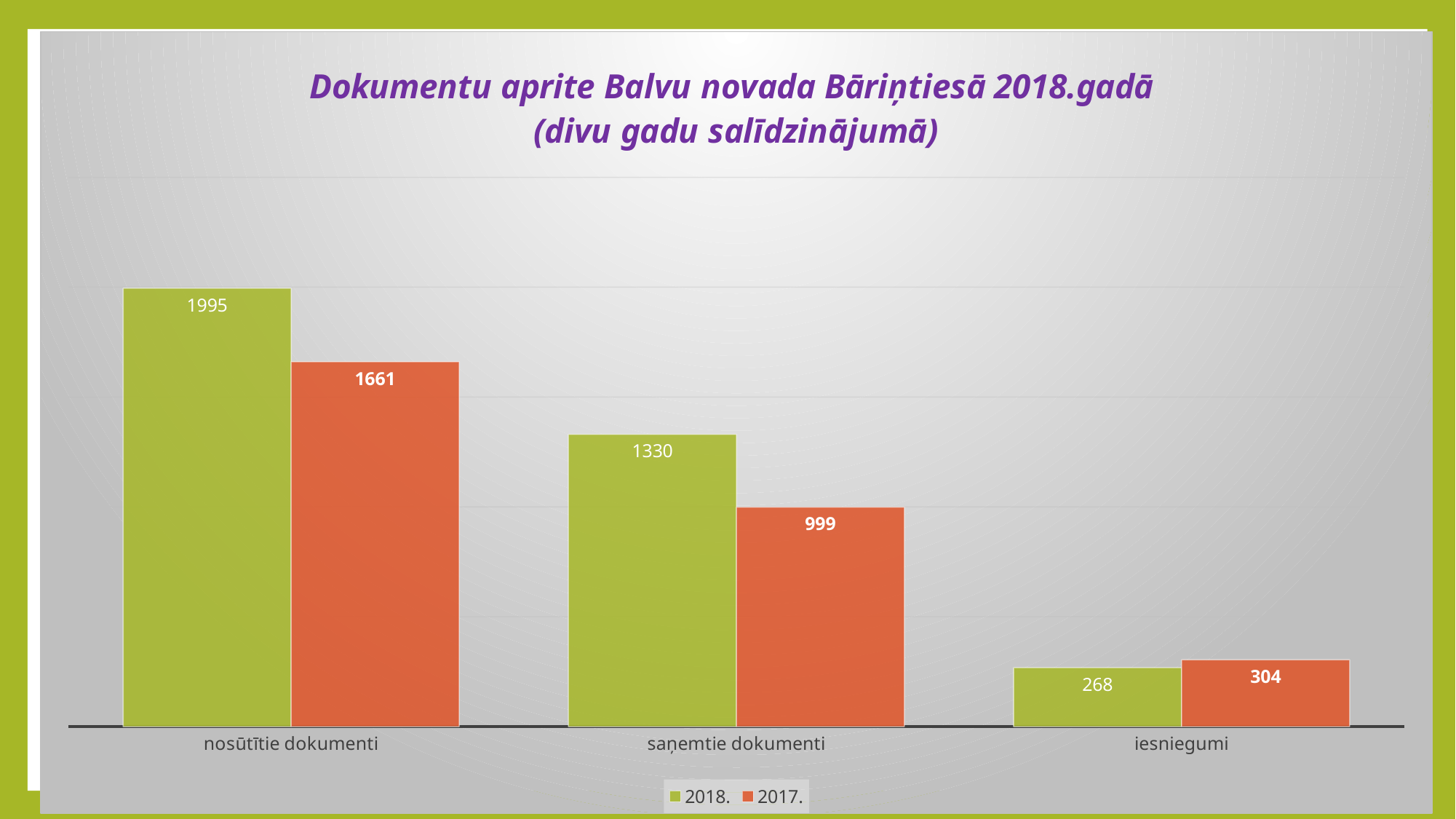
How many categories are shown on the x axis? 3 What is the value for saņemtie dokumenti in 2017.? 999 What is the difference between the 2018. and 2017. values for saņemtie dokumenti? 331 What kind of chart is shown on the slide? bar chart What is the value for iesniegumi in 2018.? 268 How many series does the legend list? 2 What is the difference between the 2018. and 2017. values for nosūtītie dokumenti? 334 What is the value for nosūtītie dokumenti in 2018.? 1995 What is the value for iesniegumi in 2017.? 304 For iesniegumi, which year has the larger value, 2018. or 2017.? 2017. Which category has the highest value for the 2018. series? nosūtītie dokumenti Which category has the lowest value for the 2017. series? iesniegumi